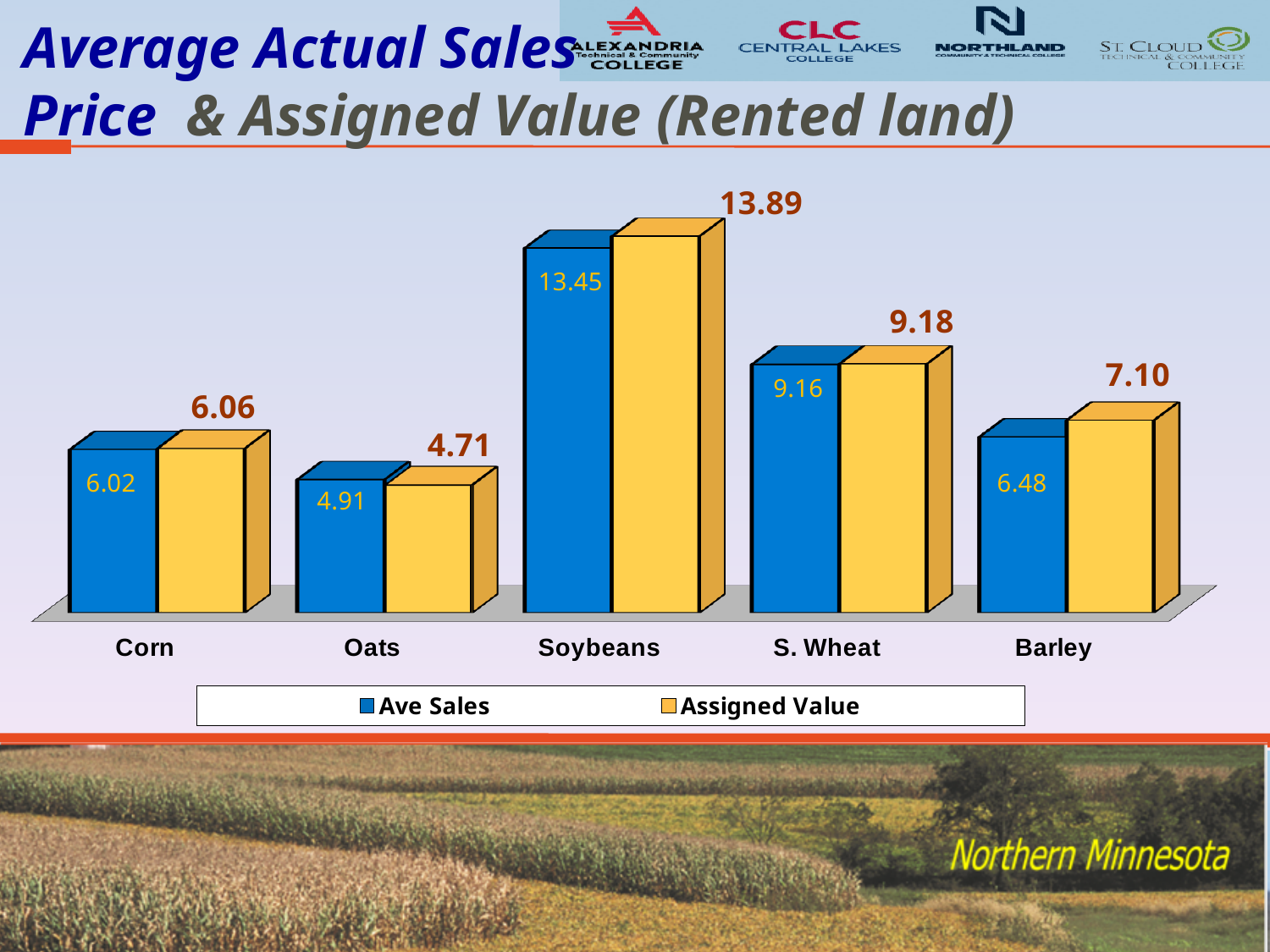
Which series is shown in yellow according to the legend? Assigned Value What is the difference between the Assigned Value for Barley and the Ave Sales for Barley? 0.62 What is the difference between the Assigned Value and Ave Sales for Soybeans? 0.44 Which category has the lowest Ave Sales value? Oats Which is larger, the Ave Sales for S. Wheat or the Ave Sales for Barley? Ave Sales for S. Wheat How many series does the legend list? 2 What is the Ave Sales value for Oats? 4.91 What kind of chart is shown on the slide? Bar chart What is the Assigned Value for Barley? 7.10 Which category has the highest Assigned Value? Soybeans What is the Ave Sales value for Soybeans? 13.45 How many categories are shown on the x axis? 5